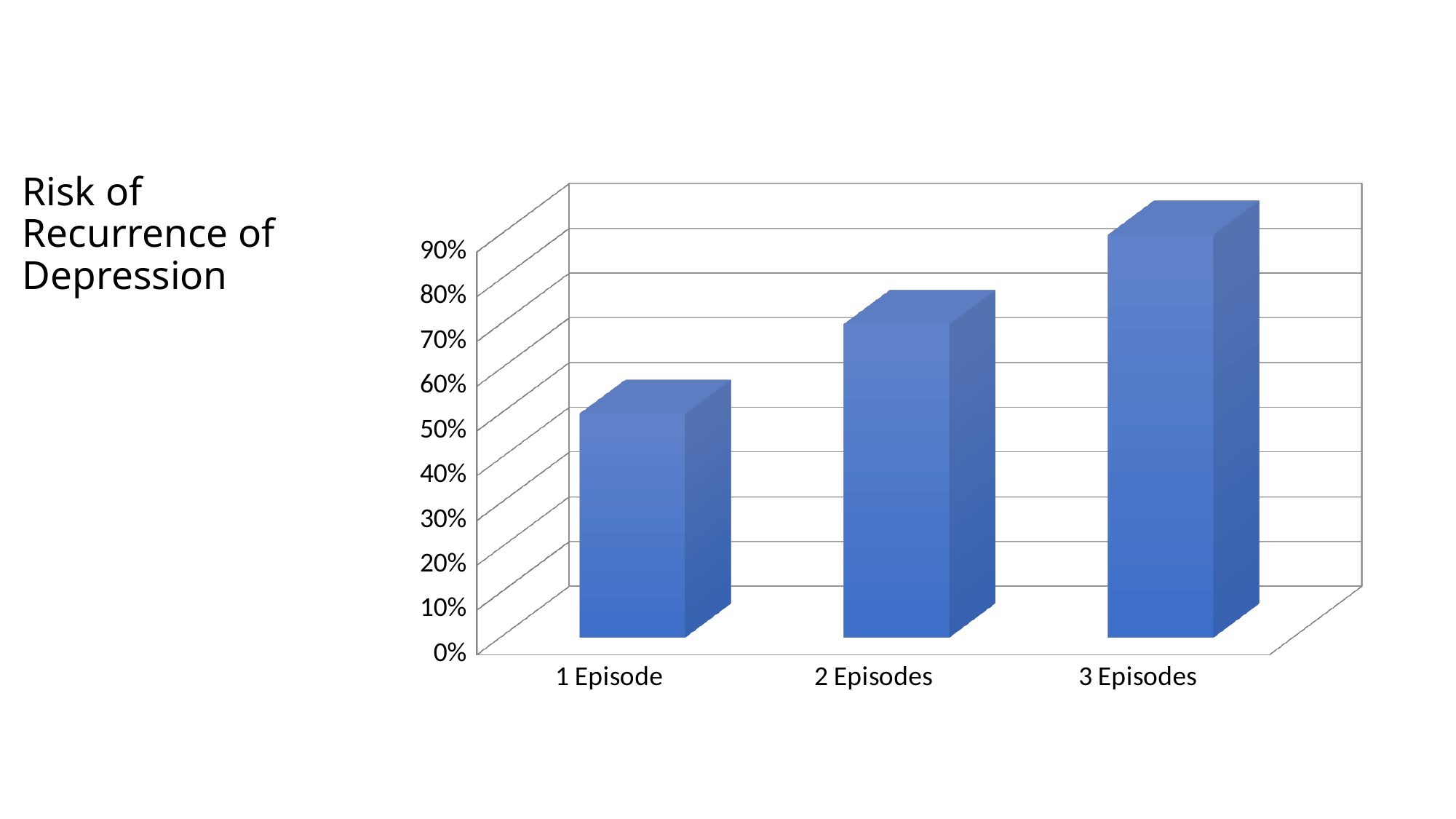
Which category has the lowest risk of recurrence? 1 Episode Is the value for 3 Episodes greater or less than 70%? greater How many categories are plotted on the x axis? 3 Which is larger, the value for 2 Episodes or the value for 3 Episodes? 3 Episodes Is the value for 2 Episodes greater or less than 50%? greater Which category has the highest risk of recurrence? 3 Episodes Is the value for 1 Episode greater or less than 70%? less Which is larger, the value for 1 Episode or the value for 2 Episodes? 2 Episodes What is the title shown next to the chart? Risk of Recurrence of Depression What kind of chart is shown on the slide? bar chart Do the values rise or fall from 1 Episode to 3 Episodes? rise